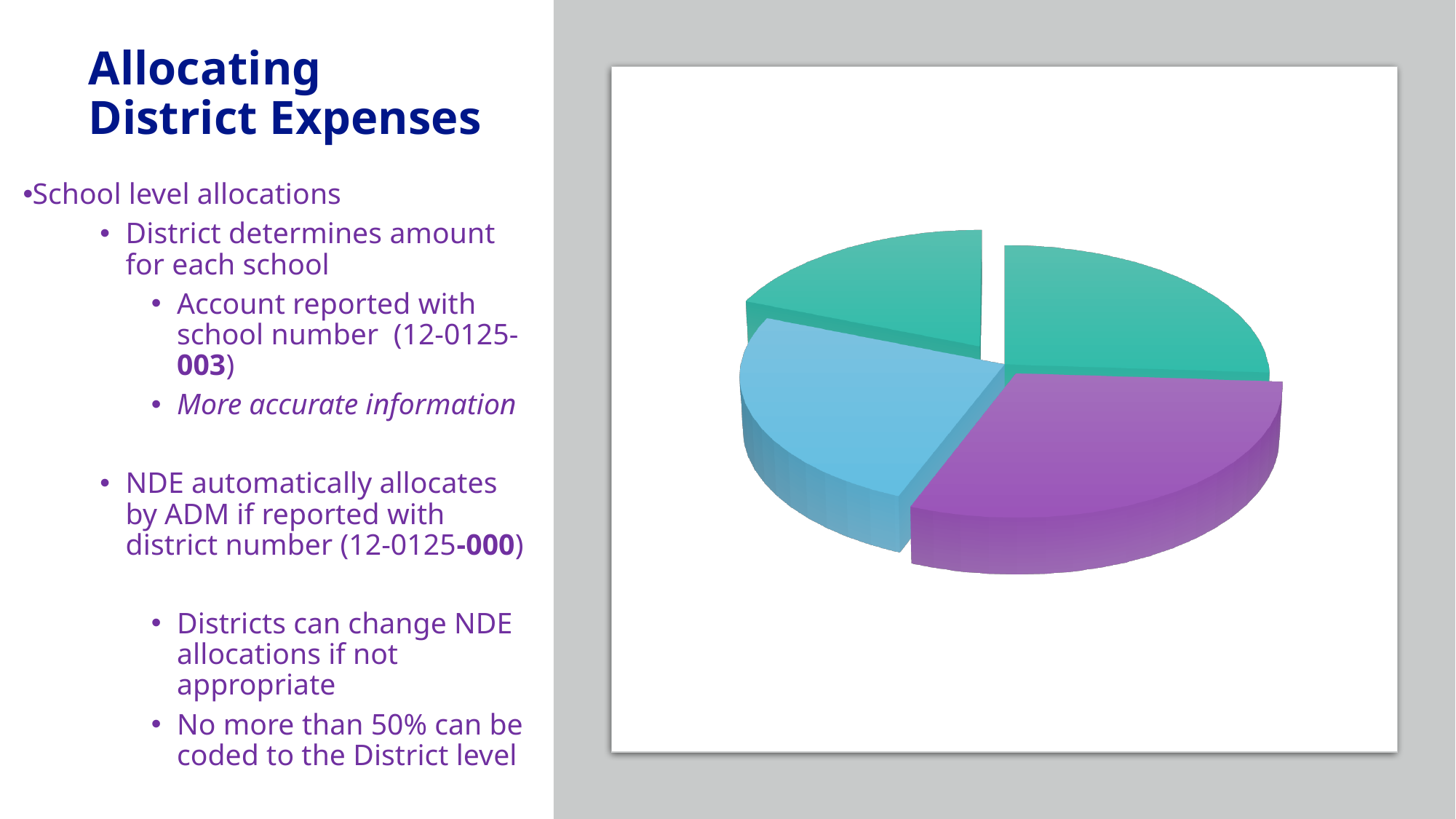
Which colour slice of the pie chart is the largest? purple Is the purple slice of the pie chart larger or smaller than the blue slice? larger What kind of chart is shown on the right side of the slide? pie chart Does the pie chart display a legend? No How many slices does the pie chart have? 4 Does the pie chart show data labels on its slices? No